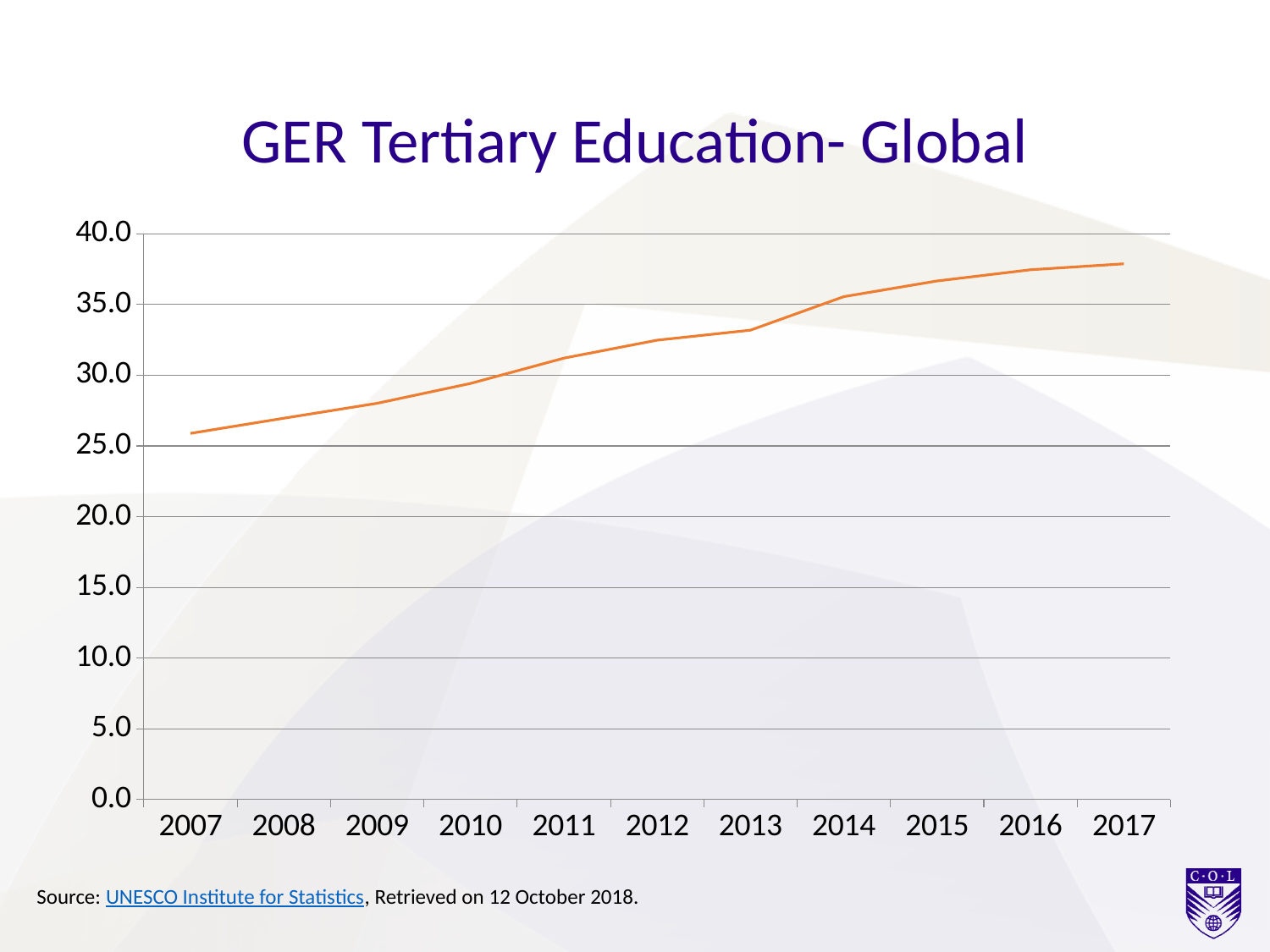
What type of chart is shown on the slide? line chart Is the value for 2012 greater or less than 35.0? less How many years are plotted along the x axis? 11 What is the title of the chart? GER Tertiary Education- Global Is the value for 2017 greater or less than 40.0? less Is the value for 2007 greater or less than 25.0? greater Which year has the highest value? 2017 Which year has the larger value, 2008 or 2015? 2015 Which year has the lowest value? 2007 Do the values rise or fall from 2007 to 2017? rise